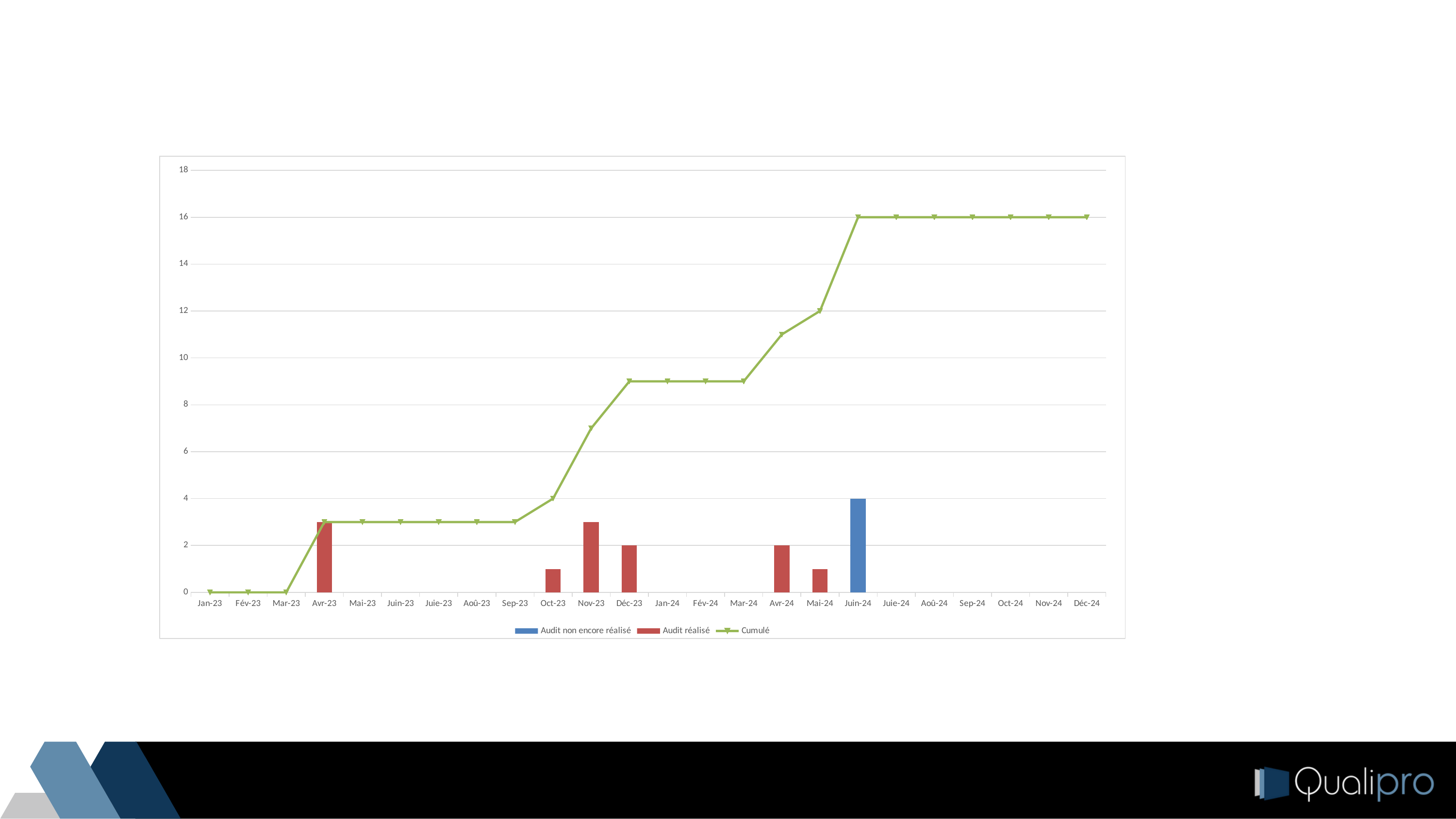
What is the value of the Audit réalisé bar at Déc-23? 2 How many series does the legend list? 3 How many months are shown on the x axis? 24 Does the Cumulé line rise or fall from Jan-23 to Déc-24? rise Is the Cumulé value at Déc-23 greater or less than 8? greater Which is larger, the Audit réalisé bar for Nov-23 or for Déc-23? Nov-23 What kind of chart is shown on the slide? A combined bar and line chart Is the Audit réalisé value for Avr-23 greater or less than 2? greater Which month has the tallest bar? Juin-24 What is the value of the Cumulé line at Mai-24? 12 What is the value of the Cumulé line at Déc-24? 16 What is the value of the Audit non encore réalisé bar at Juin-24? 4